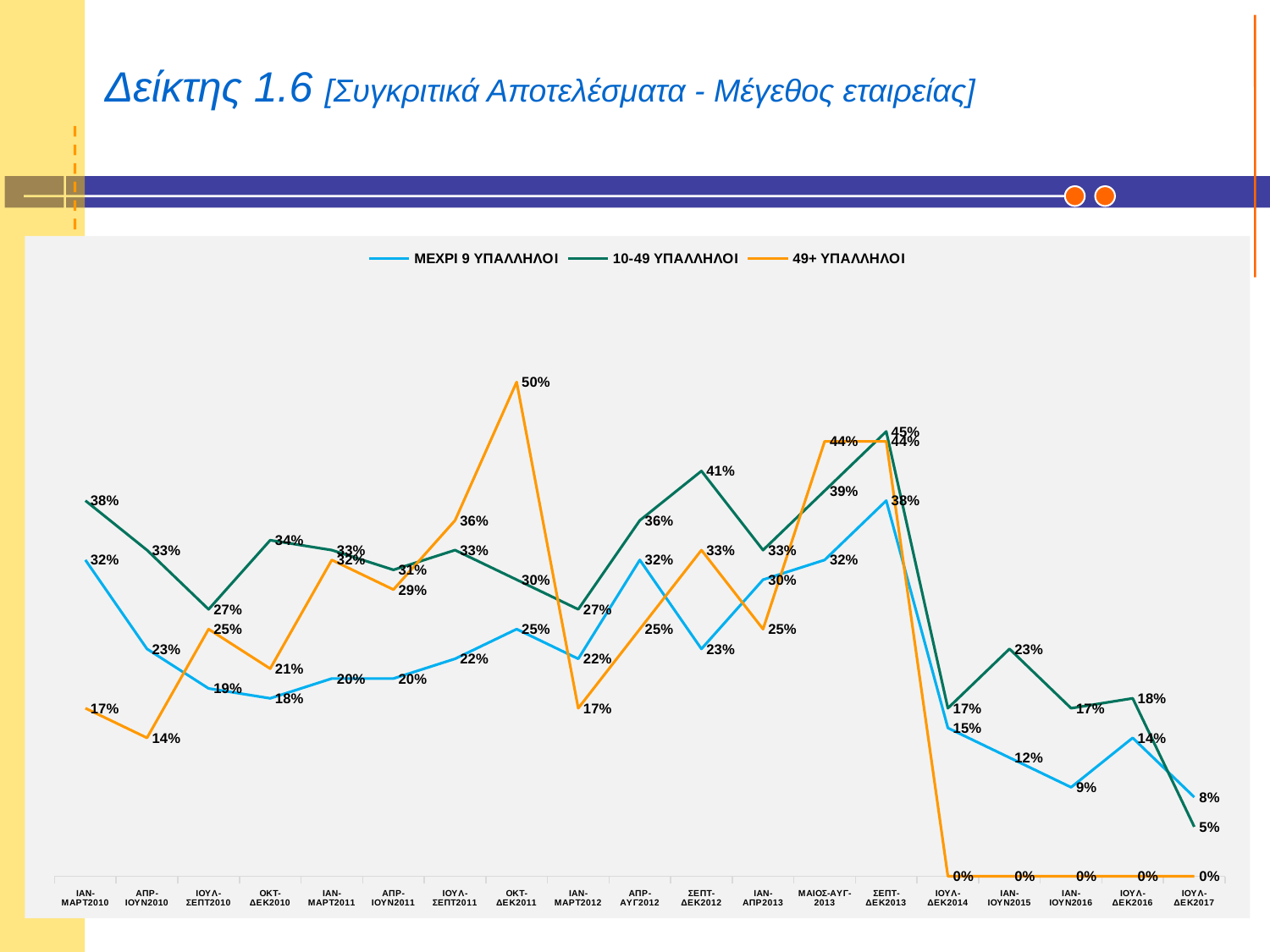
What is the value for 49+ ΥΠΑΛΛΗΛΟΙ in ΟΚΤ-ΔΕΚ2011? 50% How many time periods are shown along the x axis? 19 Does the ΜΕΧΡΙ 9 ΥΠΑΛΛΗΛΟΙ series rise or fall from ΣΕΠΤ-ΔΕΚ2013 to ΙΑΝ-ΙΟΥΝ2016? Fall In which period does the ΜΕΧΡΙ 9 ΥΠΑΛΛΗΛΟΙ series have its lowest value? ΙΟΥΛ-ΔΕΚ2017 In ΙΑΝ-ΙΟΥΝ2015, which series has the larger value: 10-49 ΥΠΑΛΛΗΛΟΙ or ΜΕΧΡΙ 9 ΥΠΑΛΛΗΛΟΙ? 10-49 ΥΠΑΛΛΗΛΟΙ What is the value for ΜΕΧΡΙ 9 ΥΠΑΛΛΗΛΟΙ in ΙΟΥΛ-ΔΕΚ2017? 8% In which period does the 49+ ΥΠΑΛΛΗΛΟΙ series reach its highest value? ΟΚΤ-ΔΕΚ2011 What is the value for 10-49 ΥΠΑΛΛΗΛΟΙ in ΙΑΝ-ΜΑΡΤ2010? 38% In ΣΕΠΤ-ΔΕΚ2012, what is the difference between the 10-49 ΥΠΑΛΛΗΛΟΙ value and the ΜΕΧΡΙ 9 ΥΠΑΛΛΗΛΟΙ value? 18 percentage points In which period does the 10-49 ΥΠΑΛΛΗΛΟΙ series reach its highest value? ΣΕΠΤ-ΔΕΚ2013 What kind of chart is shown on the slide? Line chart How many series does the legend list? 3